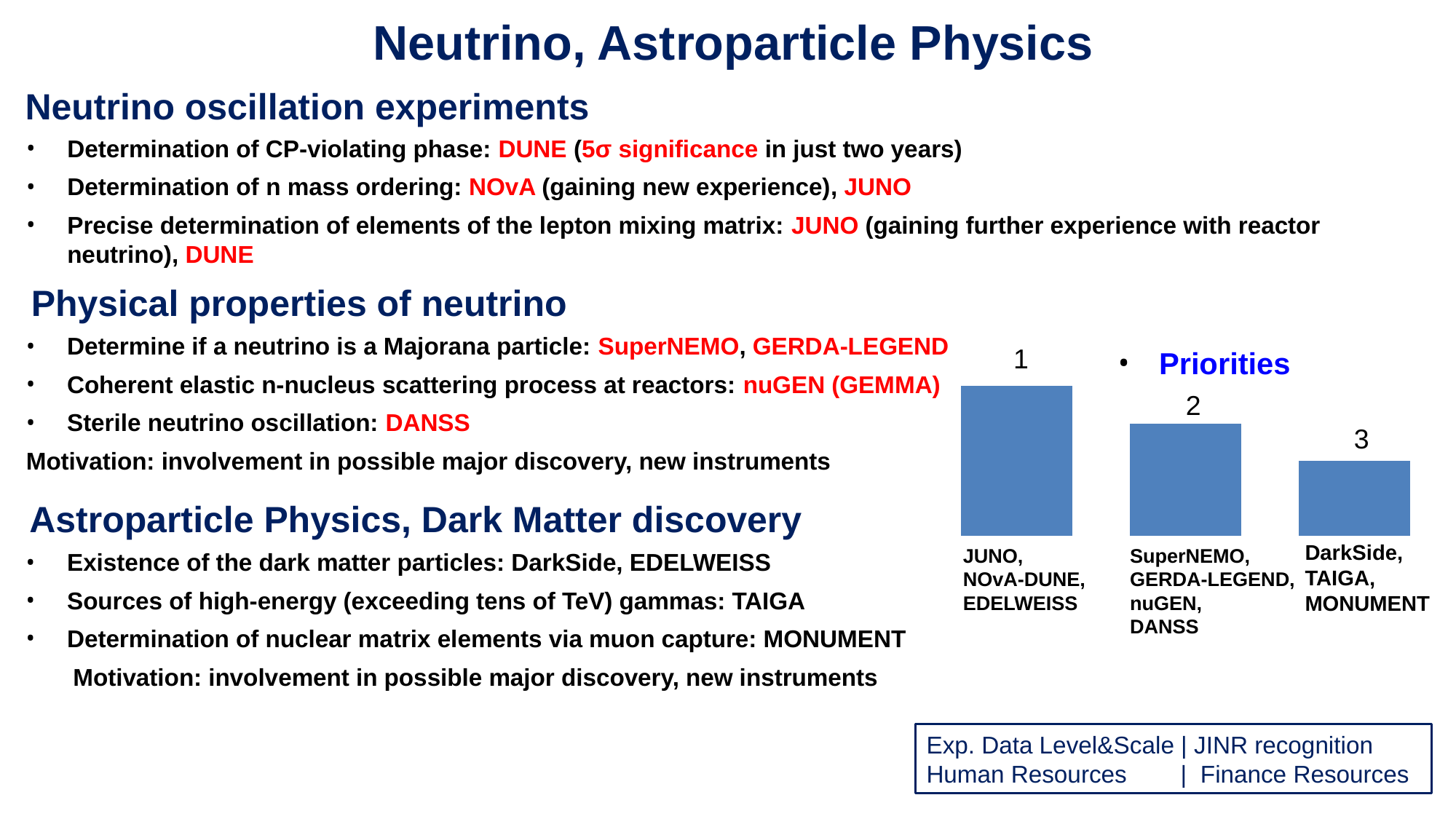
Which group of experiments has the shortest bar in the "Priorities" chart? DarkSide, TAIGA, MONUMENT What kind of chart is shown under the "Priorities" heading? bar chart Which bar is taller: the one for SuperNEMO, GERDA-LEGEND, nuGEN, DANSS or the one for DarkSide, TAIGA, MONUMENT? SuperNEMO, GERDA-LEGEND, nuGEN, DANSS What label is printed above the bar for DarkSide, TAIGA, MONUMENT? 3 Which group of experiments has the tallest bar in the "Priorities" chart? JUNO, NOvA-DUNE, EDELWEISS Which experiments are listed under the bar labelled 3? DarkSide, TAIGA, MONUMENT How many bars does the "Priorities" chart have? 3 What colour are the bars in the "Priorities" chart? blue What label is printed above the bar for JUNO, NOvA-DUNE, EDELWEISS? 1 What is the heading shown next to the bar chart? Priorities What label is printed above the bar for SuperNEMO, GERDA-LEGEND, nuGEN, DANSS? 2 Do the bar heights rise or fall from left to right in the "Priorities" chart? fall